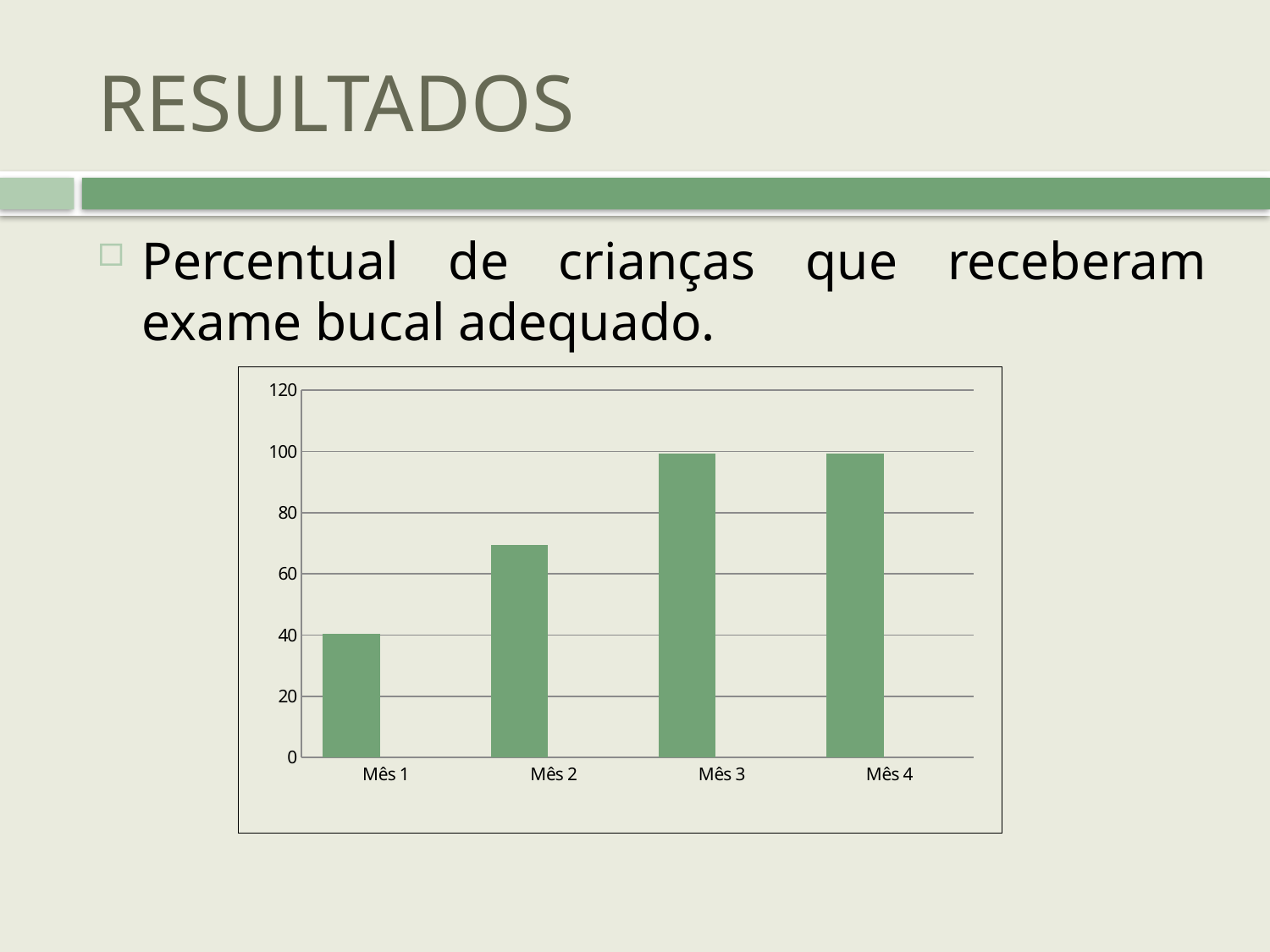
What kind of chart is shown on the slide? bar chart Is the value for Mês 4 greater or less than 120? less Which is larger, the value for Mês 1 or the value for Mês 2? Mês 2 How many categories are shown on the x axis of the chart? 4 Is the value for Mês 3 greater or less than 80? greater Which month has the lowest value in the chart? Mês 1 What is the highest tick value shown on the y axis of the chart? 120 Is the value for Mês 1 greater or less than 60? less Do the values generally rise or fall from Mês 1 to Mês 4? rise Which is larger, the value for Mês 2 or the value for Mês 3? Mês 3